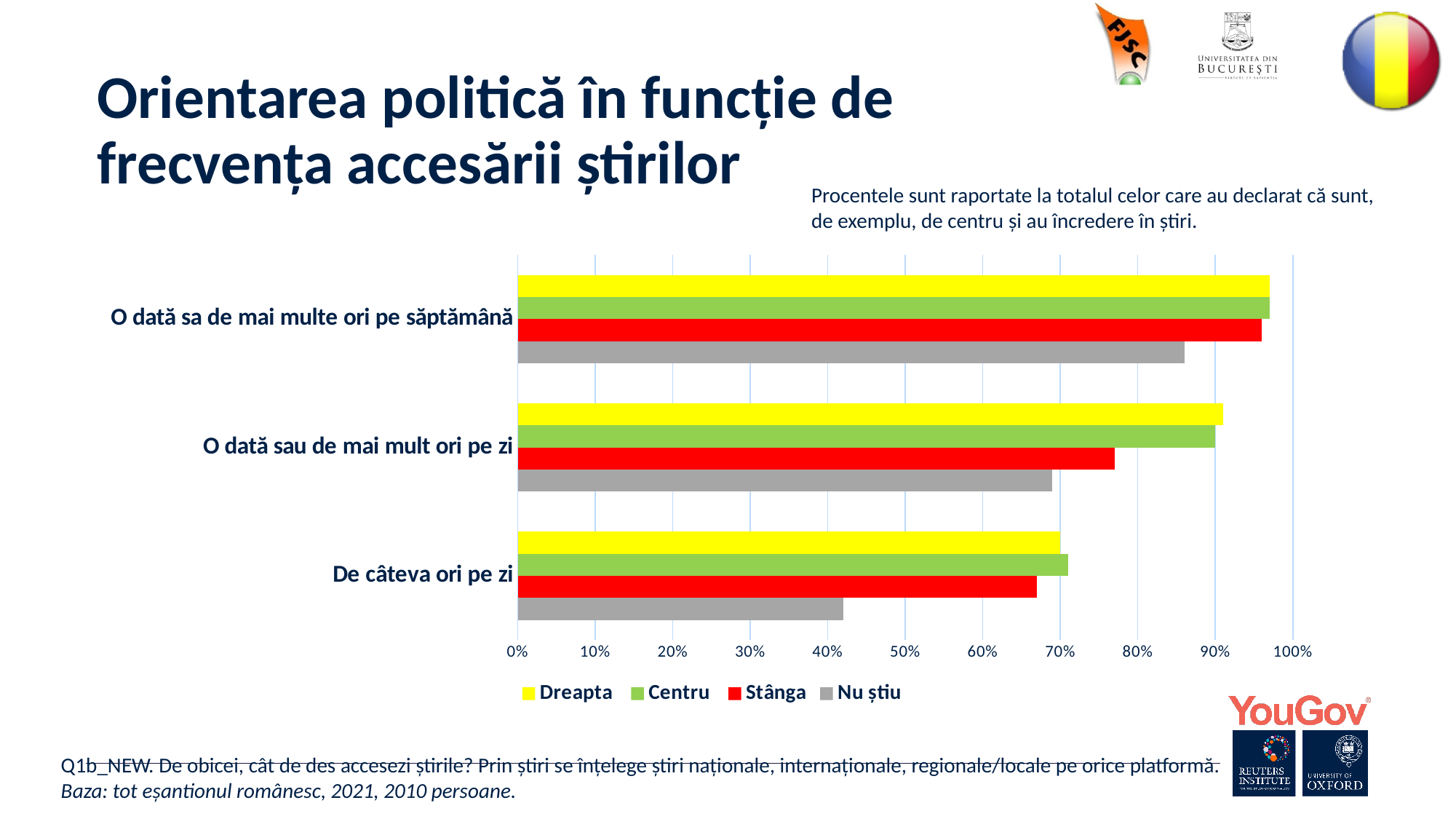
Which is larger: the Stânga value for 'O dată sau de mai mult ori pe zi' or the Stânga value for 'De câteva ori pe zi'? O dată sau de mai mult ori pe zi How many categories are shown on the vertical axis? 3 Is the value for Nu știu in the category 'O dată sau de mai mult ori pe zi' greater or less than 60%? greater Is the value for Nu știu in the category 'De câteva ori pe zi' greater or less than 50%? less Which series has the lowest value in the category 'De câteva ori pe zi'? Nu știu Is the value for Stânga in the category 'O dată sau de mai mult ori pe zi' greater or less than 70%? greater Which series has the lowest value in the category 'O dată sau de mai mult ori pe zi'? Nu știu What colour represents the Stânga series in the legend? red How many series does the legend list? 4 In which category is the Nu știu value the lowest? De câteva ori pe zi What kind of chart is shown on the slide? bar chart